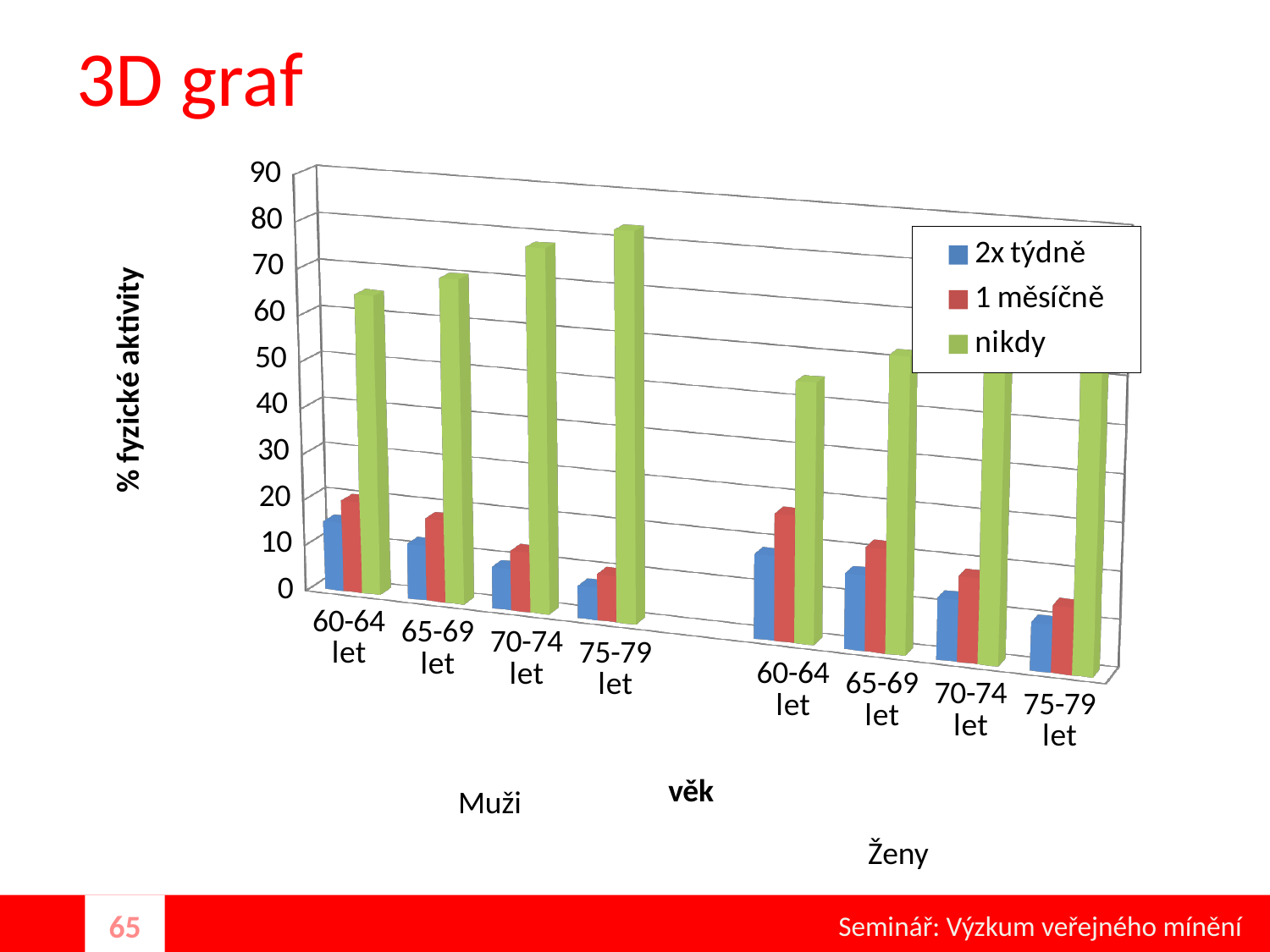
What kind of chart is shown on the slide? bar chart Among the Muži age groups, which has the highest value for nikdy? 75-79 let For Muži 60-64 let, which is larger: the value for nikdy or the value for 1 měsíčně? nikdy How many series does the legend list? 3 Among the Muži age groups, which has the lowest value for 2x týdně? 75-79 let How many age-group categories are plotted in total across Muži and Ženy? 8 Is the value for nikdy among Muži 60-64 let greater or less than 50? greater For Muži, does the value for nikdy rise or fall as the age group increases? rise Is the value for 2x týdně among Muži 60-64 let greater or less than 30? less Is the value for nikdy among Muži 75-79 let greater or less than 70? greater Which series is shown in green in the legend? nikdy What is the title of the vertical axis? % fyzické aktivity